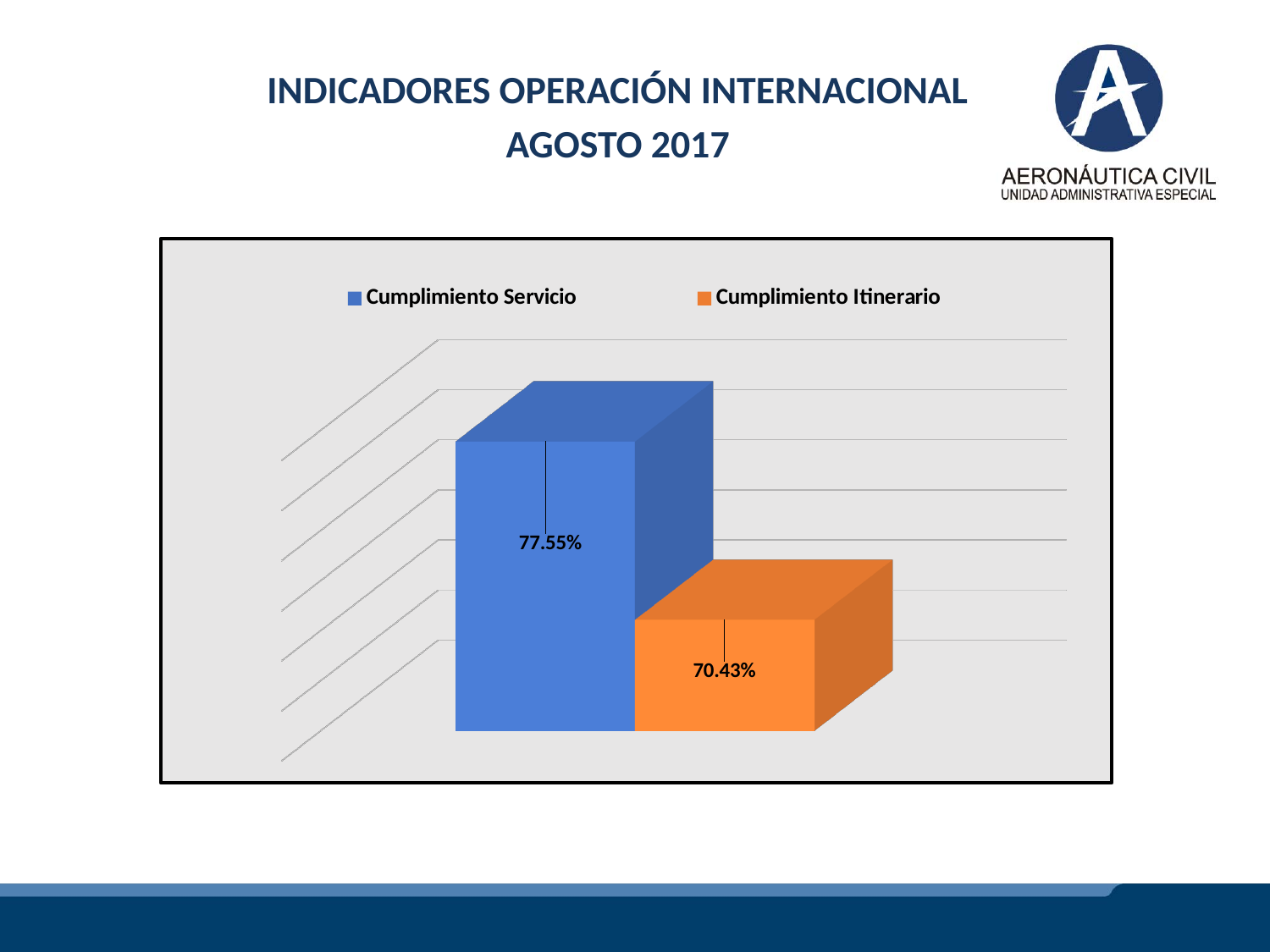
How many bars are plotted in the chart? 2 What is the value for Cumplimiento Itinerario? 70.43% Which is larger, Cumplimiento Servicio or Cumplimiento Itinerario? Cumplimiento Servicio What kind of chart is shown on the slide? Bar chart What is the value for Cumplimiento Servicio? 77.55% What is the difference between Cumplimiento Servicio and Cumplimiento Itinerario? 7.12% How many series does the legend list? 2 Which series has the lowest value? Cumplimiento Itinerario What colour is the bar for Cumplimiento Servicio? Blue Which series has the highest value? Cumplimiento Servicio What colour is the bar for Cumplimiento Itinerario? Orange